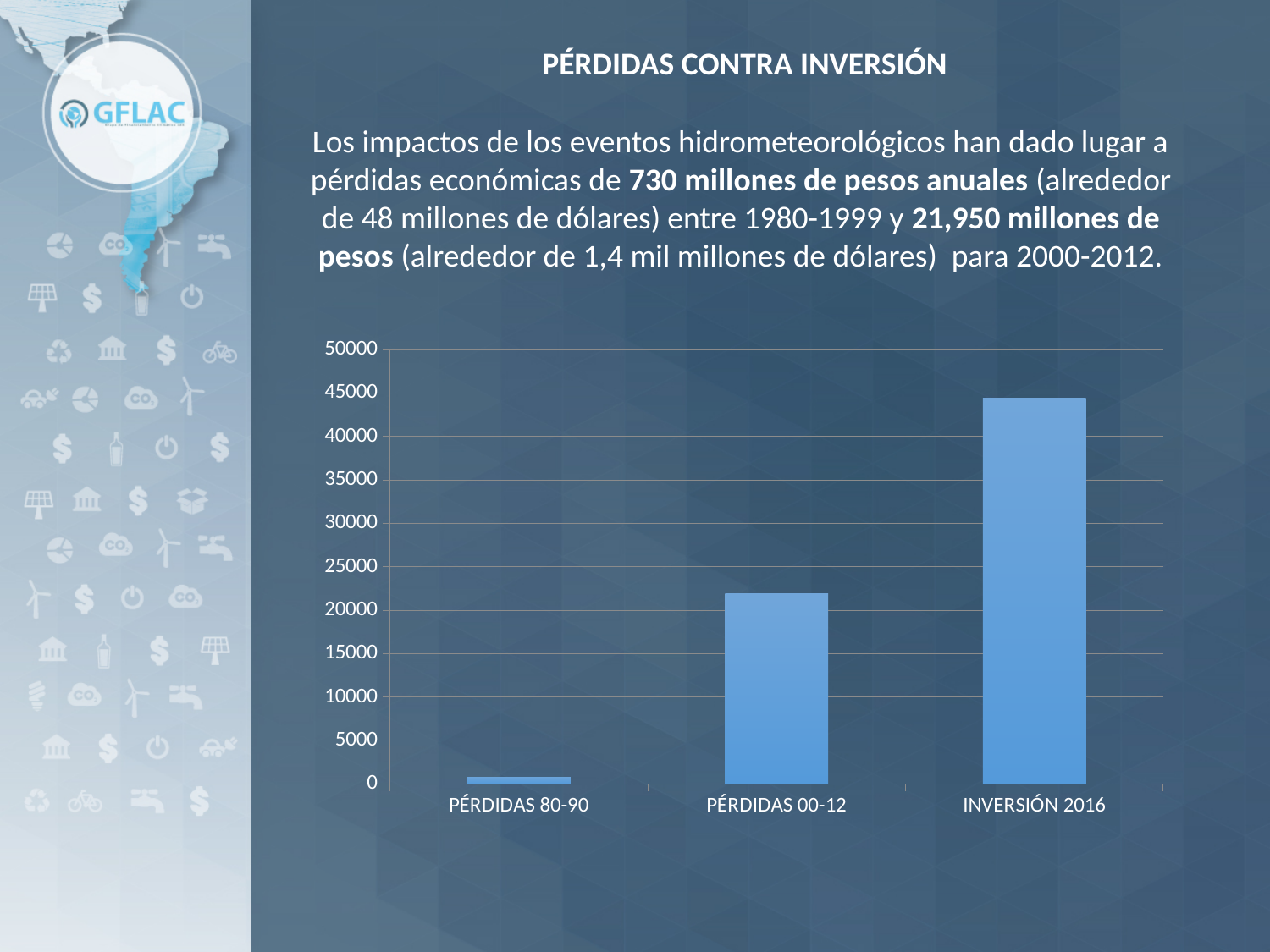
Which category has the highest value in the chart? INVERSIÓN 2016 Is the value for INVERSIÓN 2016 greater or less than 40000? greater How many categories are plotted in the chart? 3 What is the highest value shown on the vertical axis of the chart? 50000 Which is larger, the value for PÉRDIDAS 00-12 or the value for INVERSIÓN 2016? INVERSIÓN 2016 Is the value for PÉRDIDAS 00-12 greater or less than 20000? greater Is the value for PÉRDIDAS 00-12 greater or less than 25000? less Which category has the lowest value in the chart? PÉRDIDAS 80-90 Do the values rise or fall from left to right across the categories? rise What is the title shown above the chart on the slide? PÉRDIDAS CONTRA INVERSIÓN What kind of chart is shown on the slide? bar chart